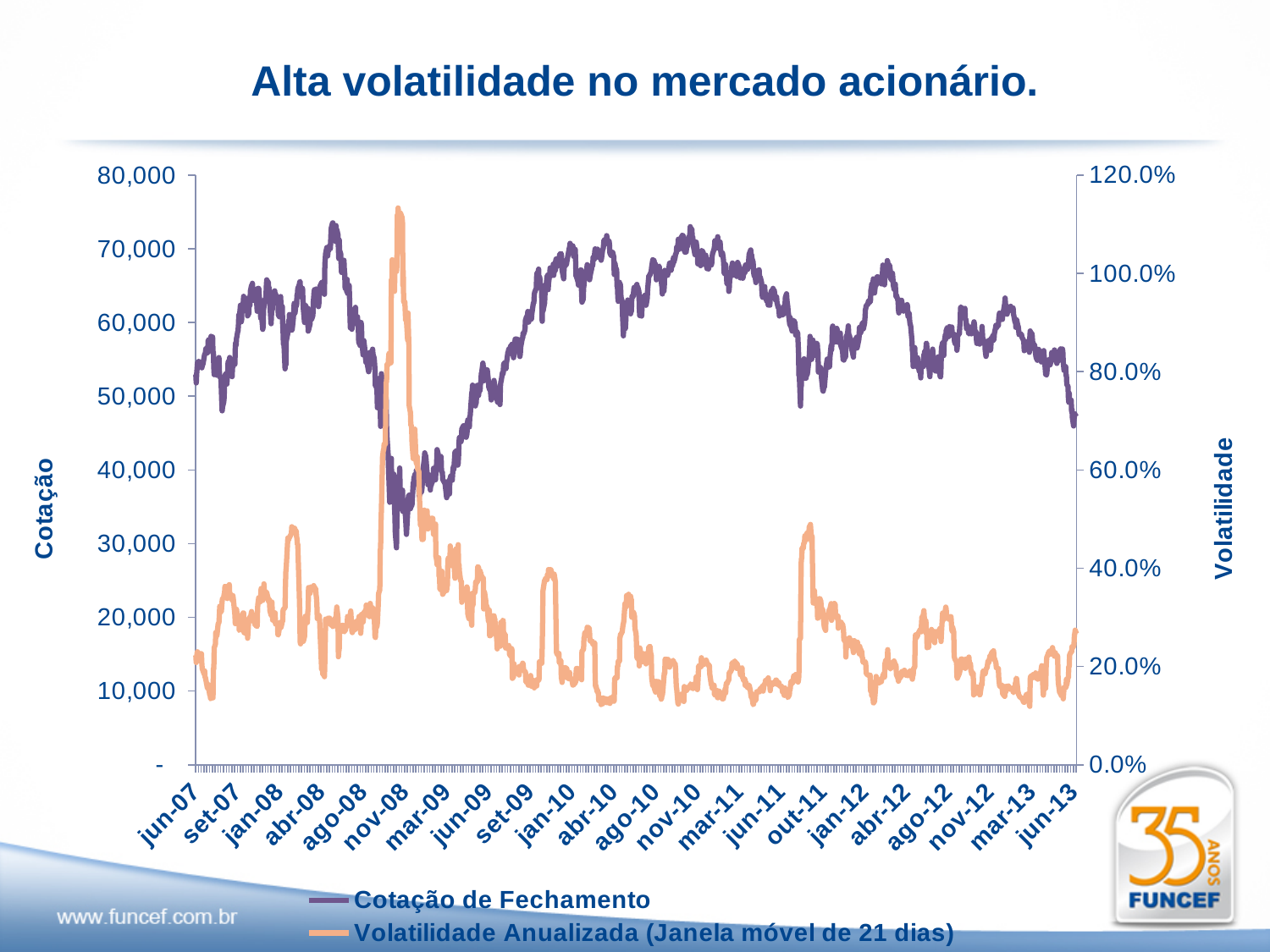
Around which x-axis label does the Volatilidade Anualizada series reach its highest peak? nov-08 Is the highest Cotação de Fechamento value around abr-08 greater or less than 70,000? greater Does Cotação de Fechamento rise or fall between abr-08 and nov-08? fall Does Volatilidade Anualizada rise or fall between nov-08 and set-09? fall Is the peak value of Volatilidade Anualizada around nov-08 greater or less than 100.0%? greater What is the title of the chart on the slide? Alta volatilidade no mercado acionário. Which series is plotted against the right-hand axis labelled Volatilidade? Volatilidade Anualizada (Janela móvel de 21 dias) Is the lowest Cotação de Fechamento value around nov-08 greater or less than 40,000? less How many date labels are shown along the x axis? 22 How many series does the legend list? 2 What kind of chart is shown on the slide? line chart